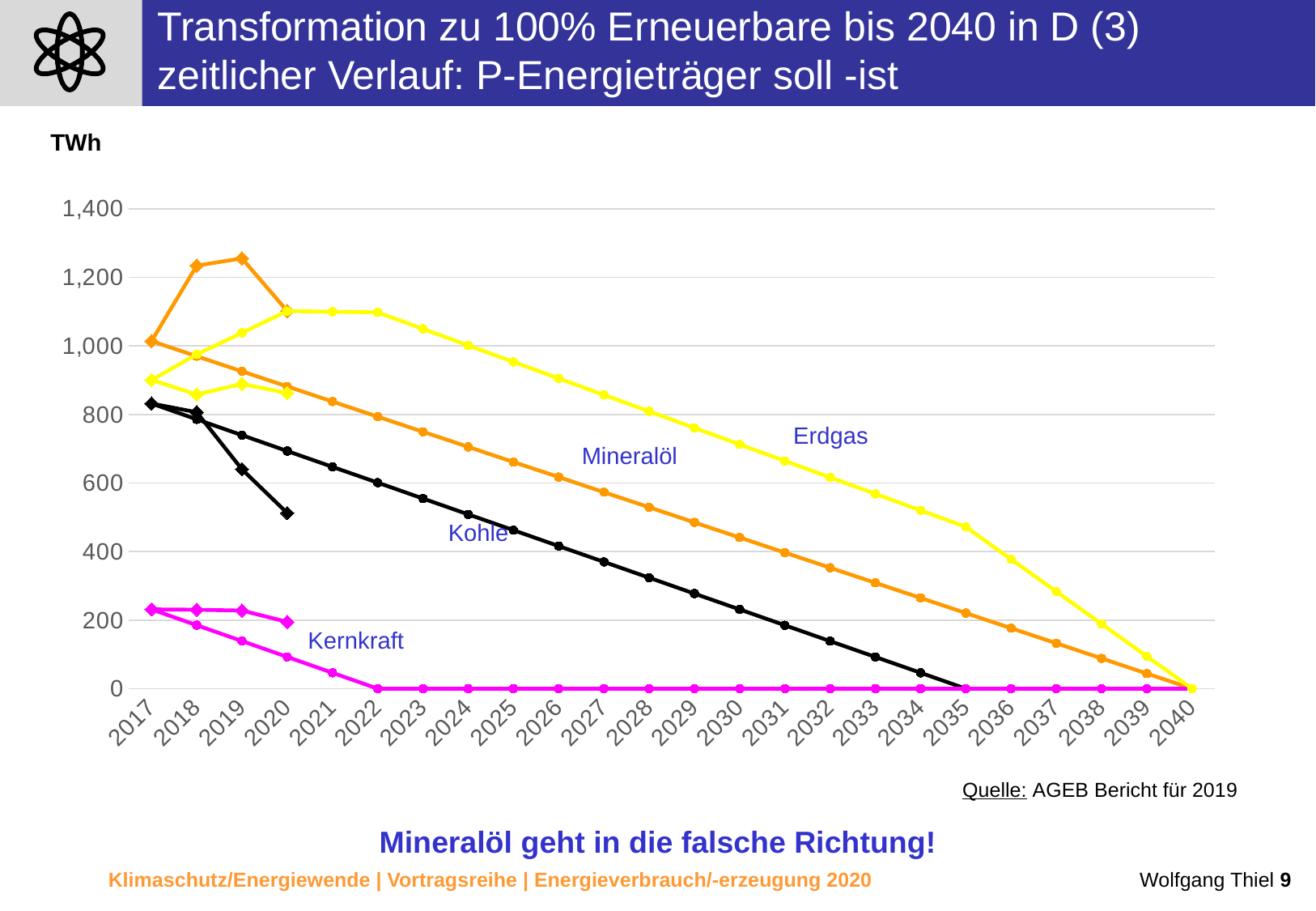
Which energy source has the highest target value in 2030? Erdgas Is the Erdgas target value for 2030 greater or less than 600? greater Does the Erdgas target line rise or fall between 2022 and 2040? fall How many years are shown along the x axis of the chart? 24 How many energy sources are labelled on the chart? 4 What kind of chart is shown on the slide? line chart In 2025, which target line is higher, Mineralöl or Kohle? Mineralöl What unit is given for the y axis of the chart? TWh What value does the Kernkraft target line show in 2022? 0 What value does the Kohle target line reach in 2035? 0 In which year do the Mineralöl and Erdgas target lines reach 0? 2040 Is the Mineralöl actual value for 2019 greater or less than 1,200? greater